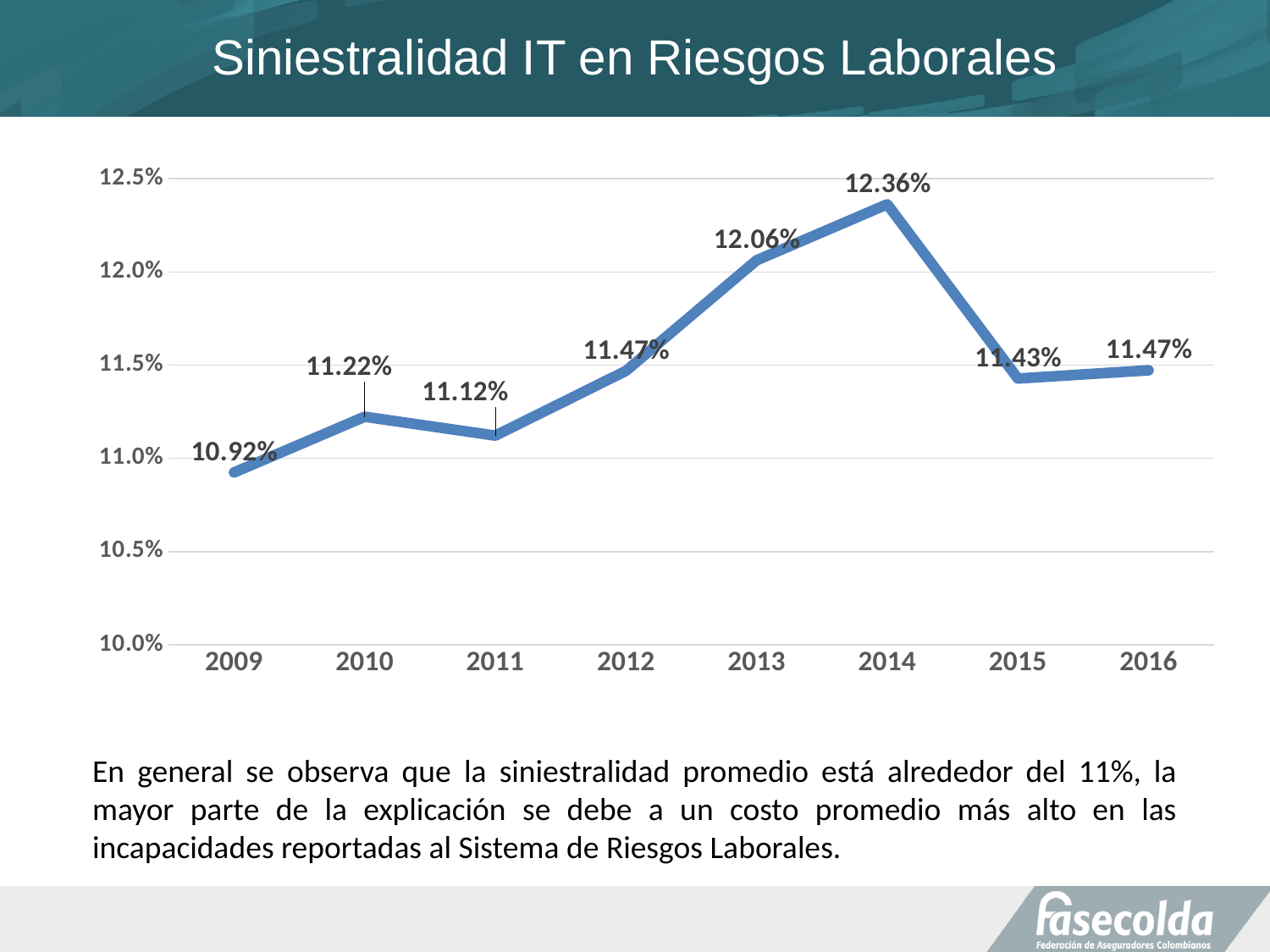
What is the difference between the values for 2014 and 2013? 0.30% Which year has the highest value? 2014 Do the values rise or fall from 2011 to 2014? rise What kind of chart is shown on the slide? line chart Which is larger, the value for 2010 or the value for 2011? 2010 Is the value for 2013 greater or less than 12.0%? greater What is the value for 2014? 12.36% What is the value for 2009? 10.92% How many years are plotted on the chart? 8 What is the title of the slide containing the chart? Siniestralidad IT en Riesgos Laborales What is the value for 2011? 11.12% Which year has the lowest value? 2009